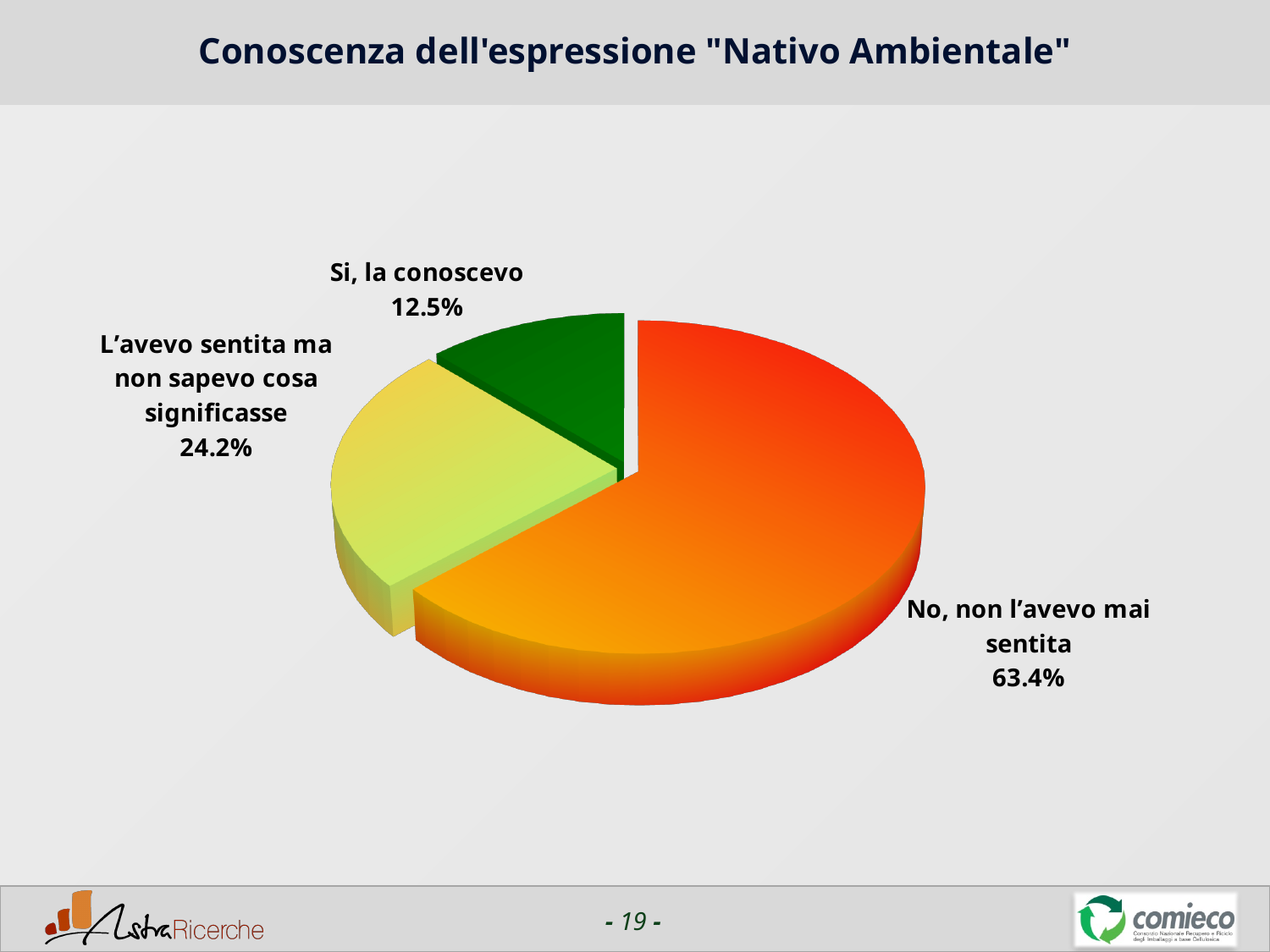
What kind of chart is shown on the slide? Pie chart How many slices does the pie chart have? 3 What is the difference in percentage points between "No, non l'avevo mai sentita" and "L'avevo sentita ma non sapevo cosa significasse"? 39.2 What is the title of the chart? Conoscenza dell'espressione "Nativo Ambientale" What is the difference in percentage points between "L'avevo sentita ma non sapevo cosa significasse" and "Si, la conoscevo"? 11.7 What colour is the slice for "Si, la conoscevo"? Dark green Which response has the largest share of the pie? No, non l'avevo mai sentita Which is larger: the share for "Si, la conoscevo" or the share for "L'avevo sentita ma non sapevo cosa significasse"? L'avevo sentita ma non sapevo cosa significasse Which response has the smallest share of the pie? Si, la conoscevo What percentage of respondents answered "No, non l'avevo mai sentita"? 63.4% What percentage of respondents answered "L'avevo sentita ma non sapevo cosa significasse"? 24.2% What percentage of respondents answered "Si, la conoscevo"? 12.5%